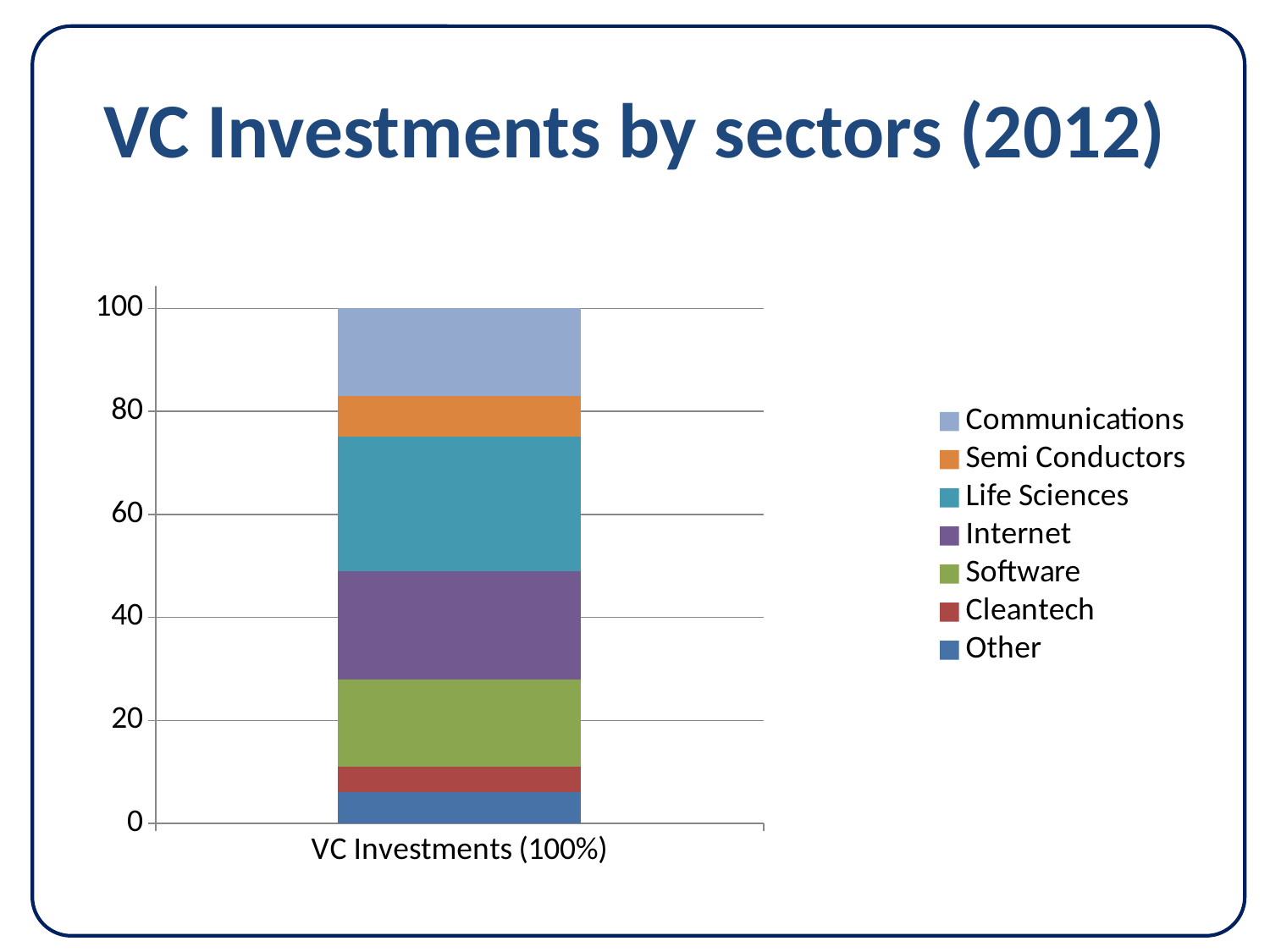
How many bars (categories) are plotted on the x axis? 1 Is the Semi Conductors segment greater or less than 20? less Is the Life Sciences segment greater or less than 20? greater Which segment is larger, Life Sciences or Communications? Life Sciences What is the label of the category on the x axis? VC Investments (100%) Which segment is larger, Internet or Semi Conductors? Internet What is the title of the slide? VC Investments by sectors (2012) How many series does the legend list? 7 Which sector has the largest segment in the stacked bar? Life Sciences What is the total height of the stacked bar for VC Investments (100%)? 100 What kind of chart is shown on the slide? Stacked bar chart